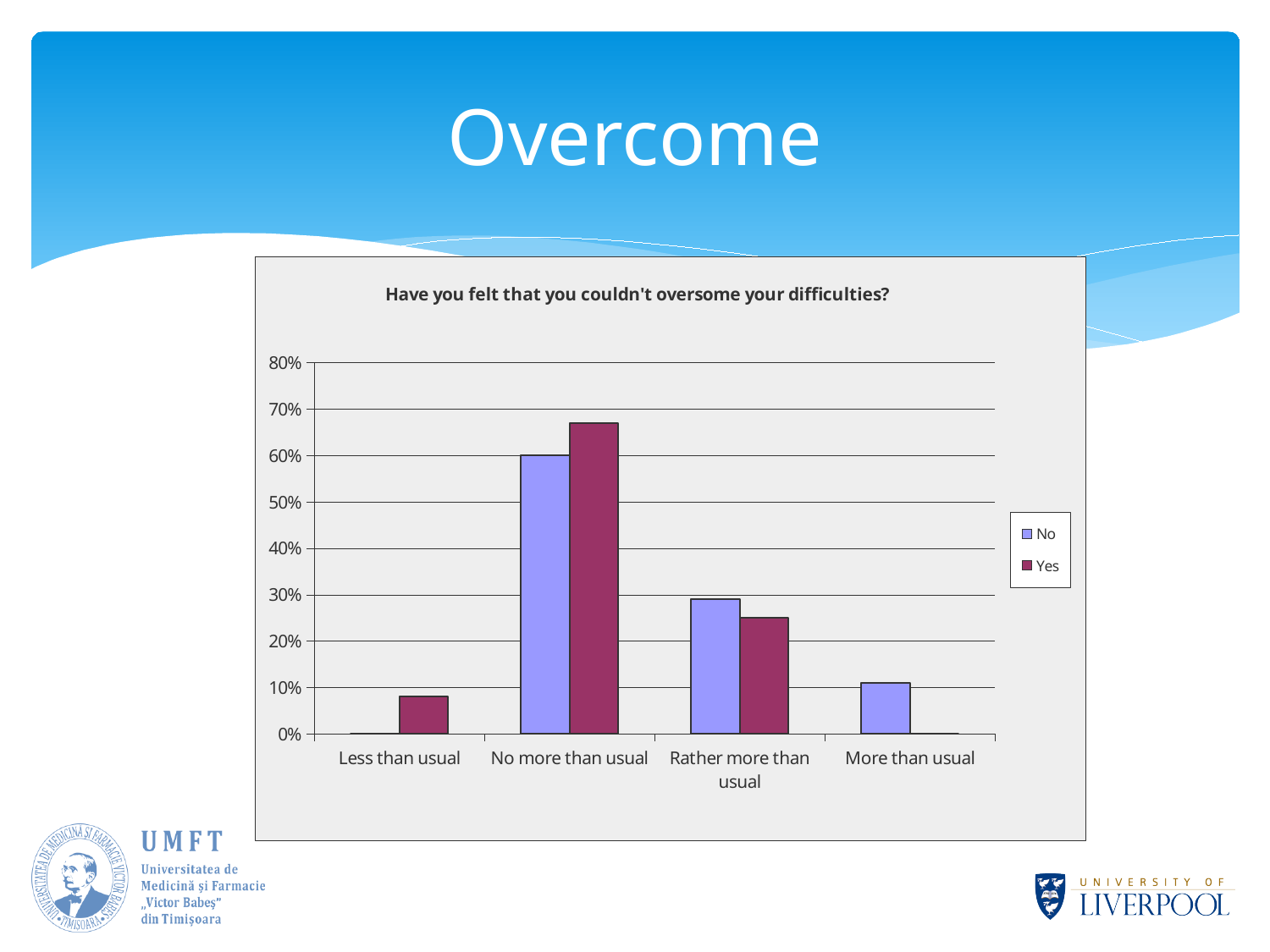
Which category has the highest value for the Yes series? No more than usual Which category has the highest value for the No series? No more than usual Is the value for Yes in the 'Less than usual' category greater or less than 10%? less How many series does the chart's legend list? 2 For the category 'No more than usual', which series has the larger value, No or Yes? Yes Is the value for Yes in the 'No more than usual' category greater or less than 60%? greater How many categories are shown on the x axis of the chart? 4 Is the value for No in the 'Rather more than usual' category greater or less than 20%? greater Which series is shown in the dark red/purple colour in the chart? Yes What kind of chart is shown on the slide? bar chart What is the title of the chart? Have you felt that you couldn't oversome your difficulties? For the category 'Rather more than usual', which series has the larger value, No or Yes? No